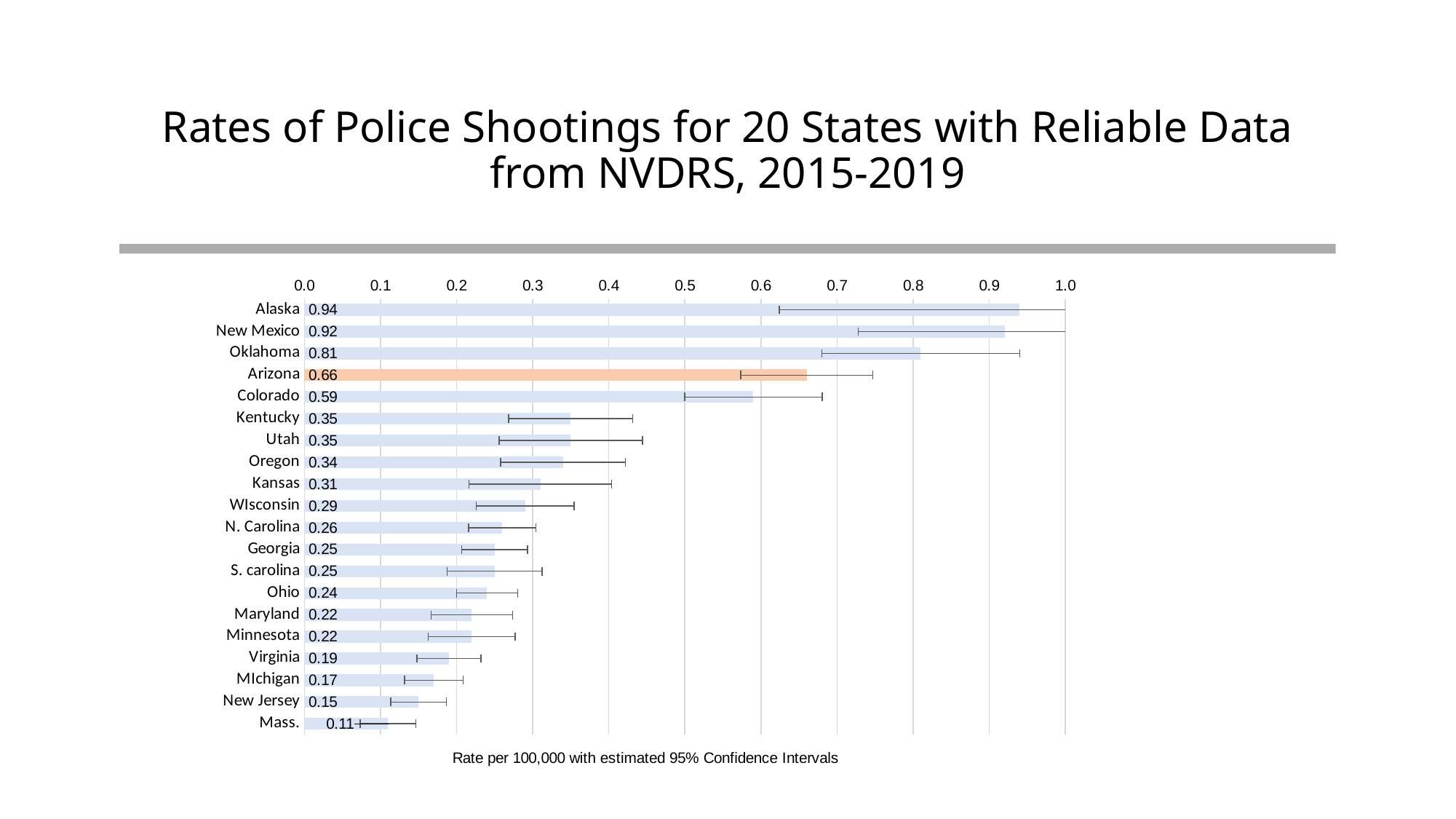
What is the difference between the rates for Oklahoma and Colorado? 0.22 Which state's bar is highlighted in orange? Arizona What is the rate of police shootings for Arizona? 0.66 Which state has the highest rate of police shootings? Alaska What is the rate of police shootings for Wisconsin? 0.29 How many states are shown in the chart? 20 What is the rate of police shootings for Colorado? 0.59 Which state has the lowest rate of police shootings? Mass. What does the label below the x axis say the rates are measured in? Rate per 100,000 with estimated 95% Confidence Intervals What kind of chart is shown on the slide? Bar chart What is the difference between the rates for Alaska and New Mexico? 0.02 Which has a higher rate of police shootings, Kansas or Ohio? Kansas